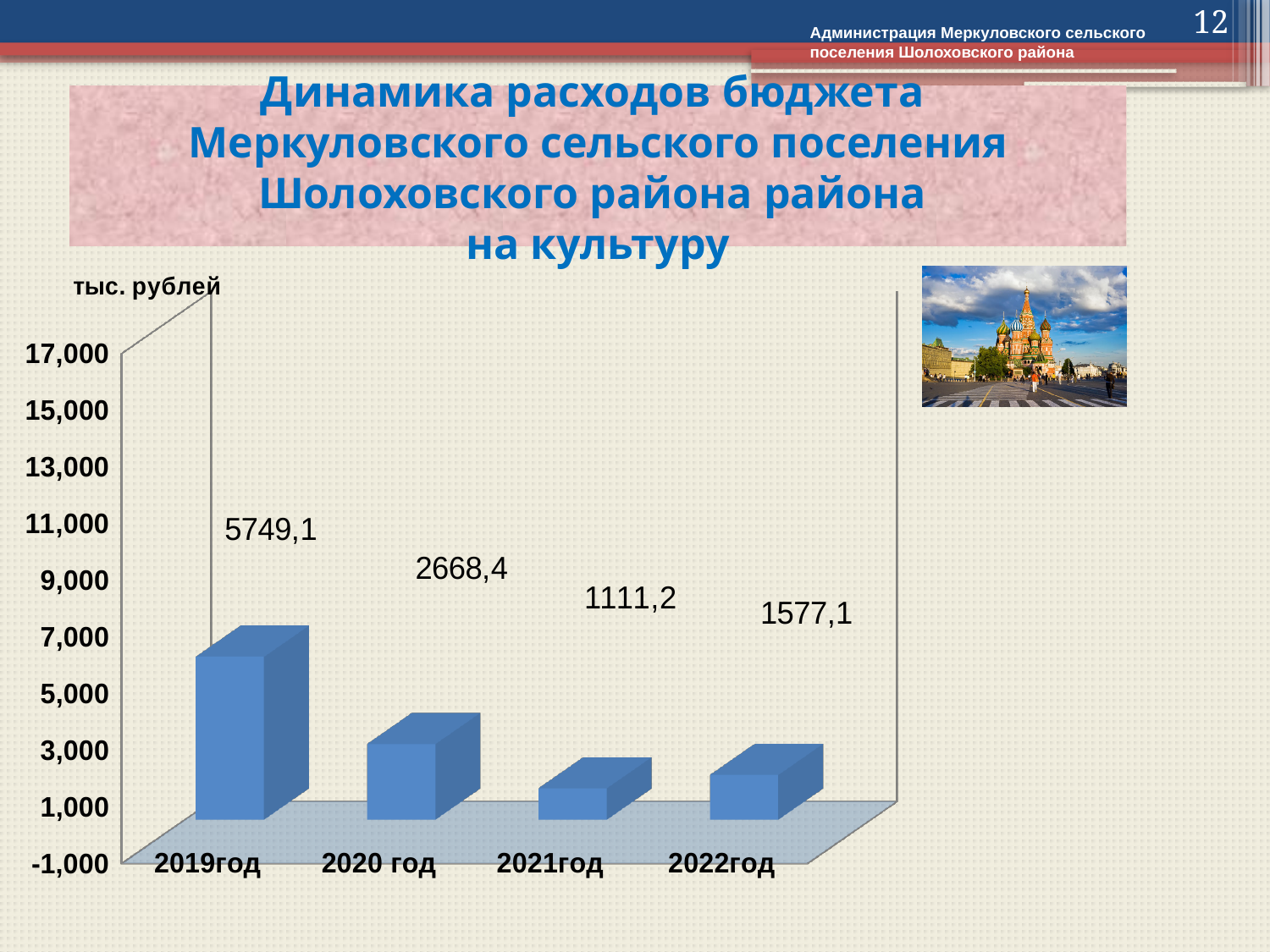
How many years are shown on the chart? 4 What is the value for 2021год? 1111,2 Which year has the highest value? 2019год What kind of chart is shown on the slide? bar chart Is the value for 2020 год greater or less than 3,000? less What is the value for 2022год? 1577,1 What is the difference between the values for 2019год and 2020 год? 3080,7 What is the value for 2019год? 5749,1 Which is larger, the value for 2021год or the value for 2022год? 2022год What is the difference between the values for 2022год and 2021год? 465,9 What is the value for 2020 год? 2668,4 Which year has the lowest value? 2021год